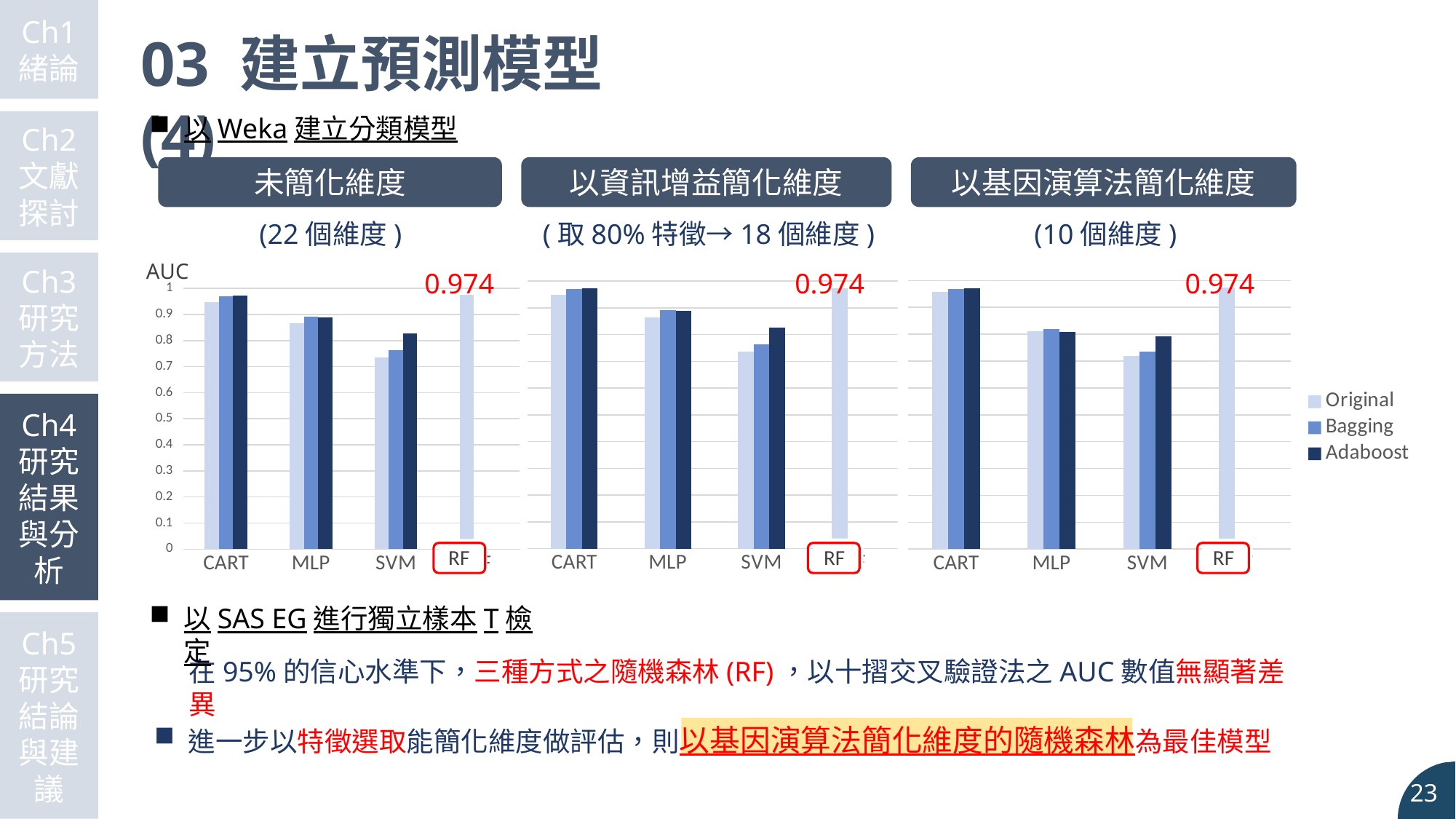
In the right chart (以基因演算法簡化維度), is the Original value for MLP greater or less than 0.8? greater What kind of chart is used in the left chart (未簡化維度)? bar chart In the middle chart (以資訊增益簡化維度), what AUC value is labeled for RF? 0.974 In the left chart (未簡化維度), is the Original value for CART greater or less than 0.9? greater In the right chart (以基因演算法簡化維度), what AUC value is labeled for RF? 0.974 In the left chart (未簡化維度), which is larger, the Original value for CART or the Original value for SVM? CART How many categories are shown on the x axis of the left chart (未簡化維度)? 4 What are the three series names listed in the legend? Original, Bagging, Adaboost How many series does the legend list for the charts? 3 In the left chart (未簡化維度), what AUC value is labeled for RF? 0.974 In the left chart (未簡化維度), which of CART, MLP and SVM has the lowest Original value? SVM In the left chart (未簡化維度), is the Original value for SVM greater or less than 0.8? less